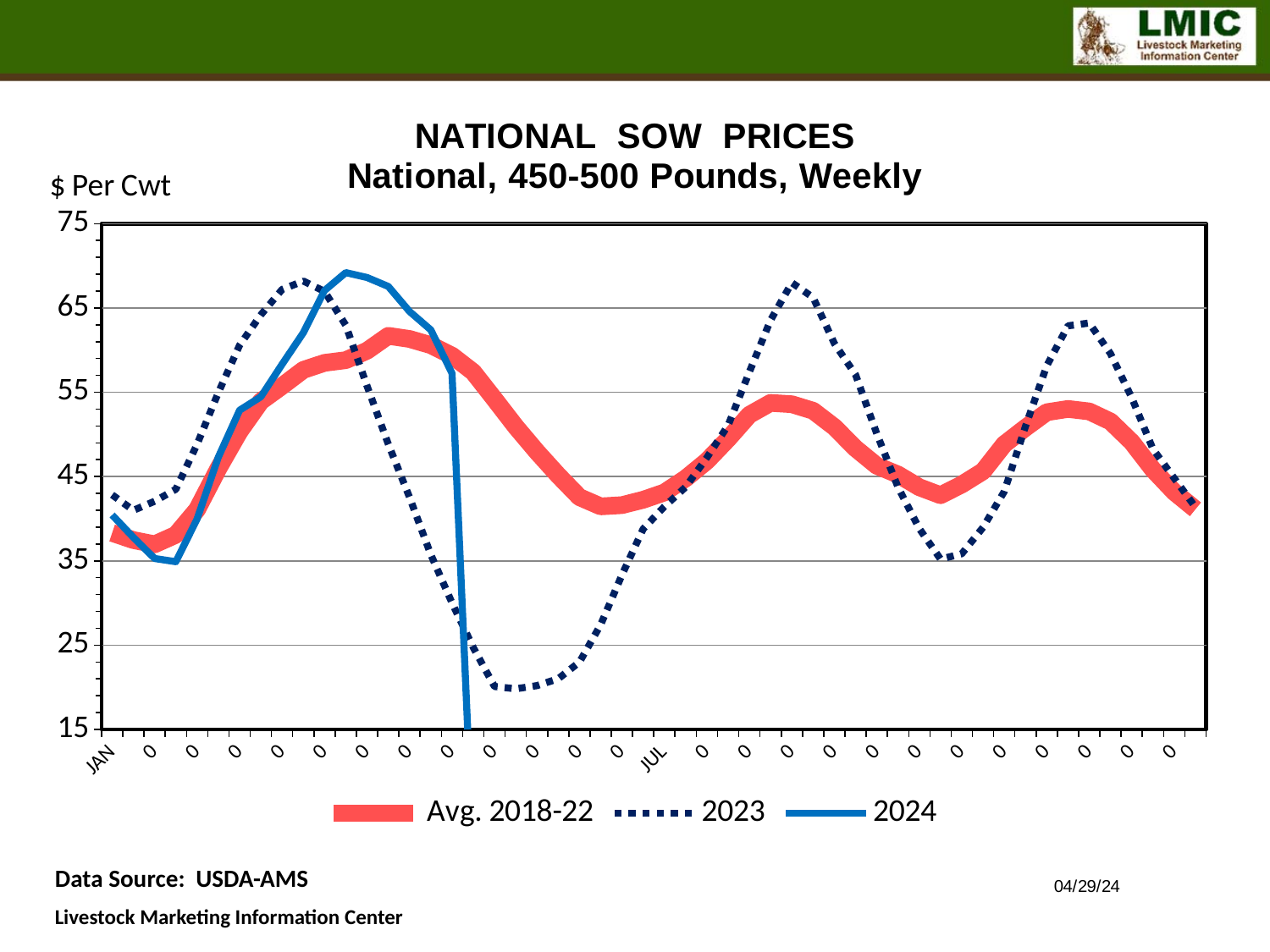
Is the highest value of the 2024 line greater or less than 65? greater Is the value of the 2024 line at JAN greater or less than 35? greater What kind of chart is shown on the slide? line chart Is the highest value of the Avg. 2018-22 line greater or less than 65? less Does the 2024 line rise or fall from JAN to its peak? rise What unit is shown on the y axis of the chart? $ Per Cwt Does the 2023 line rise or fall from its early-year peak to its lowest point? fall How many series does the legend list? 3 Which series reaches a higher peak value, 2024 or Avg. 2018-22? 2024 What are the three series listed in the legend? Avg. 2018-22, 2023, 2024